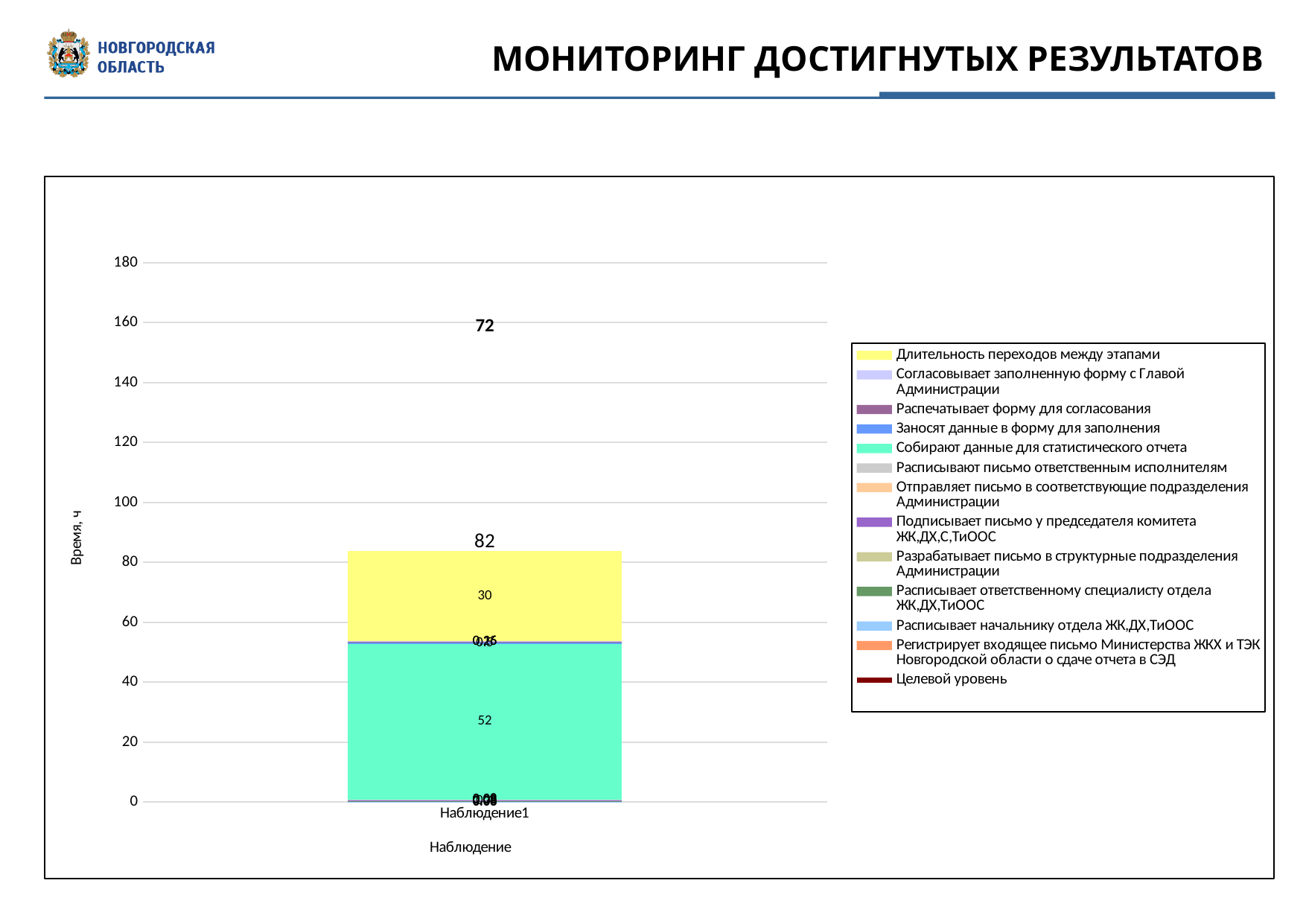
What value is shown for 'Целевой уровень'? 72 How many series does the legend list? 13 What is the total of the stacked bar for Наблюдение1? 82 Which is larger for Наблюдение1: 'Собирают данные для статистического отчета' or 'Длительность переходов между этапами'? Собирают данные для статистического отчета What kind of chart is shown on the slide? Stacked bar chart Which segment of the bar for Наблюдение1 is the largest? Собирают данные для статистического отчета What is the value of the segment 'Собирают данные для статистического отчета' for Наблюдение1? 52 What is the title of the vertical axis? Время, ч How many categories are plotted on the x axis? 1 What is the value of the segment 'Длительность переходов между этапами' for Наблюдение1? 30 Is the total of the stacked bar for Наблюдение1 greater or less than 100? less What is the difference between the 'Собирают данные для статистического отчета' segment (52) and the 'Длительность переходов между этапами' segment (30)? 22